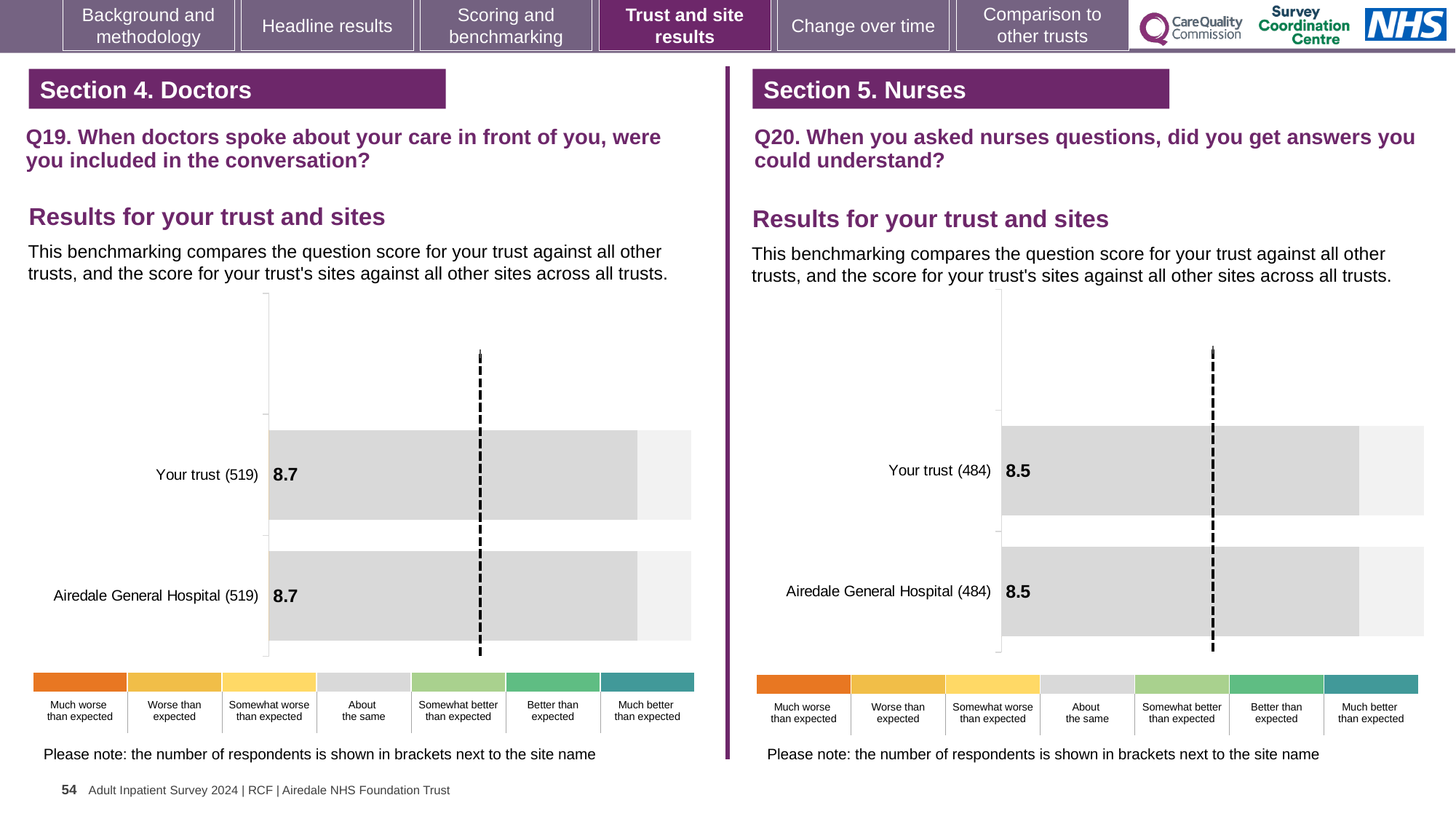
Which is larger: the Your trust score in the Q19 chart on the left or the Your trust score in the Q20 chart on the right? Q19 chart (8.7) How many bars are plotted in the Q20 chart on the right? 2 In the Q19 chart on the left, what is the score for Airedale General Hospital? 8.7 How many bars are plotted in the Q19 chart on the left? 2 In the Q20 chart on the right, what is the score for Your trust? 8.5 In the Q20 chart on the right, how many respondents are shown in brackets next to Airedale General Hospital? 484 In the Q19 chart on the left, what is the score for Your trust? 8.7 In the Q20 chart on the right, what is the score for Airedale General Hospital? 8.5 What is the difference between the Your trust score in the Q19 chart on the left and the Your trust score in the Q20 chart on the right? 0.2 In the Q19 chart on the left, is the score for Your trust greater or less than the score for Airedale General Hospital? Neither, they are equal (8.7) What kind of chart is used for the Q19 results on the left? Bar chart In the Q19 chart on the left, how many respondents are shown in brackets next to Your trust? 519